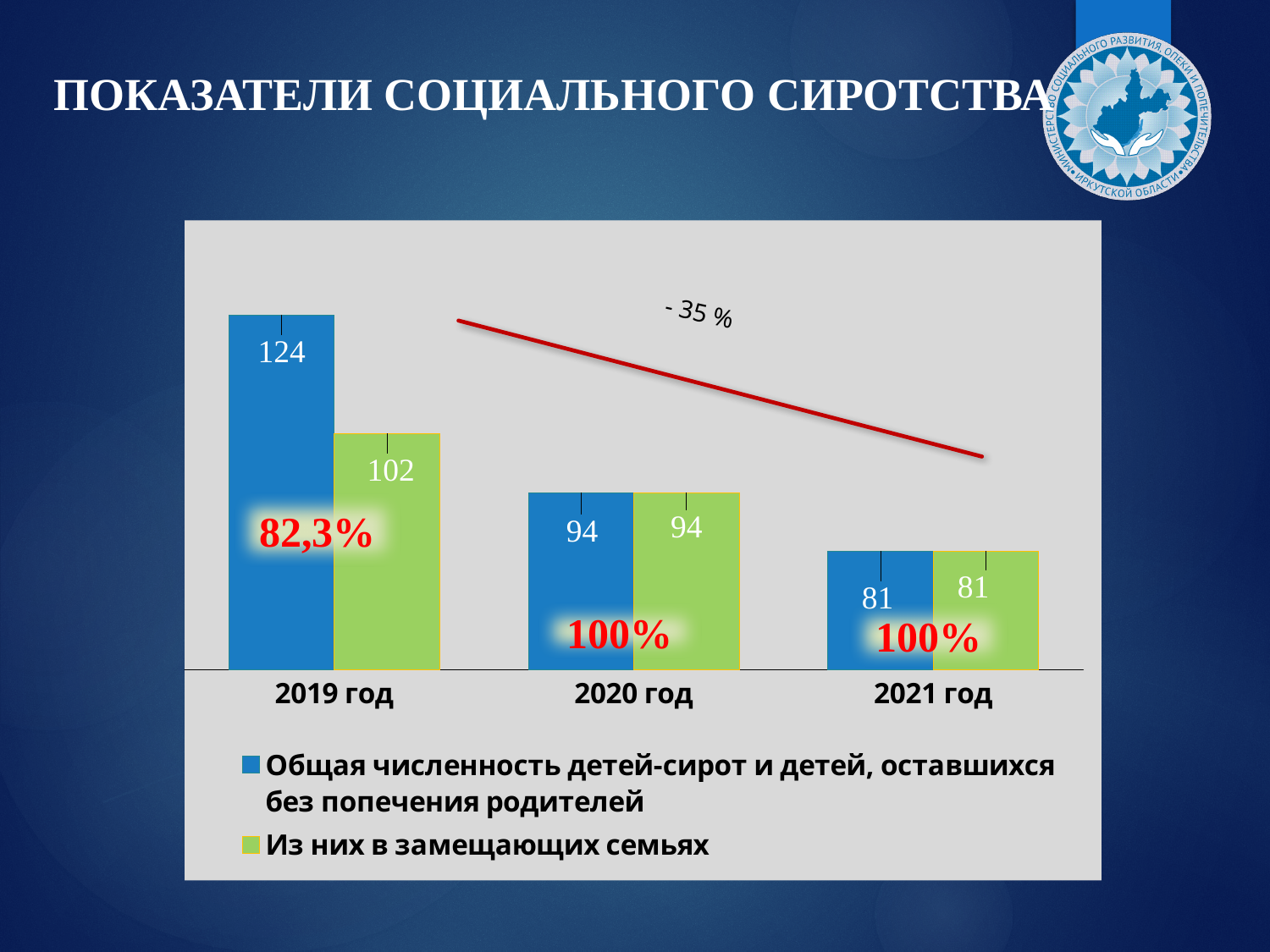
What is the value of 'Из них в замещающих семьях' for 2019 год? 102 By how much did 'Общая численность детей-сирот и детей, оставшихся без попечения родителей' decrease from 2019 год to 2021 год? 43 What is the difference between the two series values for 2019 год? 22 What is the value of 'Из них в замещающих семьях' for 2020 год? 94 Which is larger: 'Из них в замещающих семьях' in 2019 год or 'Общая численность детей-сирот и детей, оставшихся без попечения родителей' in 2020 год? 'Из них в замещающих семьях' in 2019 год What is the value of 'Общая численность детей-сирот и детей, оставшихся без попечения родителей' for 2021 год? 81 Which year has the highest value for 'Общая численность детей-сирот и детей, оставшихся без попечения родителей'? 2019 год Which year has the lowest value for 'Из них в замещающих семьях'? 2021 год How many series does the legend list? 2 What is the value of 'Общая численность детей-сирот и детей, оставшихся без попечения родителей' for 2019 год? 124 How many year categories are shown on the x axis? 3 What kind of chart is shown on the slide? Bar chart